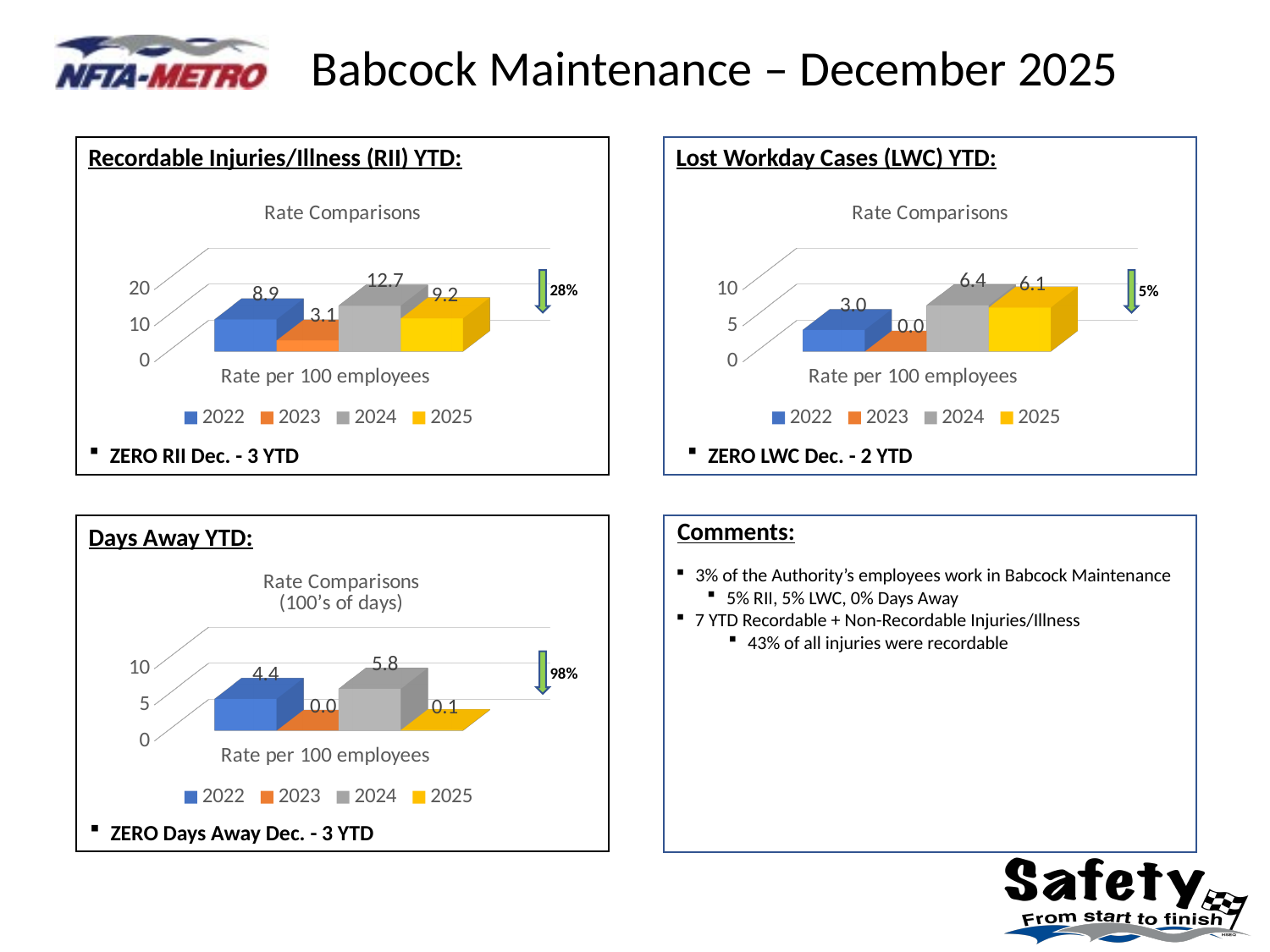
In the Lost Workday Cases (LWC) YTD chart, what is the rate for 2022? 3.0 In the Days Away YTD chart, what is the rate for 2025? 0.1 How many series does the legend list in the Recordable Injuries/Illness (RII) YTD chart? 4 What is the title of the chart in the Days Away YTD box? Rate Comparisons (100's of days) In the Recordable Injuries/Illness (RII) YTD chart, what is the rate per 100 employees for 2024? 12.7 In the Recordable Injuries/Illness (RII) YTD chart, what is the difference between the 2024 and 2025 rates? 3.5 What kind of chart is shown in the Lost Workday Cases (LWC) YTD box? Bar chart In the Recordable Injuries/Illness (RII) YTD chart, which year has the lowest rate? 2023 In the Days Away YTD chart, which is larger, the 2022 rate or the 2024 rate? 2024 In the Lost Workday Cases (LWC) YTD chart, is the 2025 rate greater or less than 5? greater In the Days Away YTD chart, what is the difference between the 2024 and 2022 rates? 1.4 In the Lost Workday Cases (LWC) YTD chart, which year has the highest rate? 2024